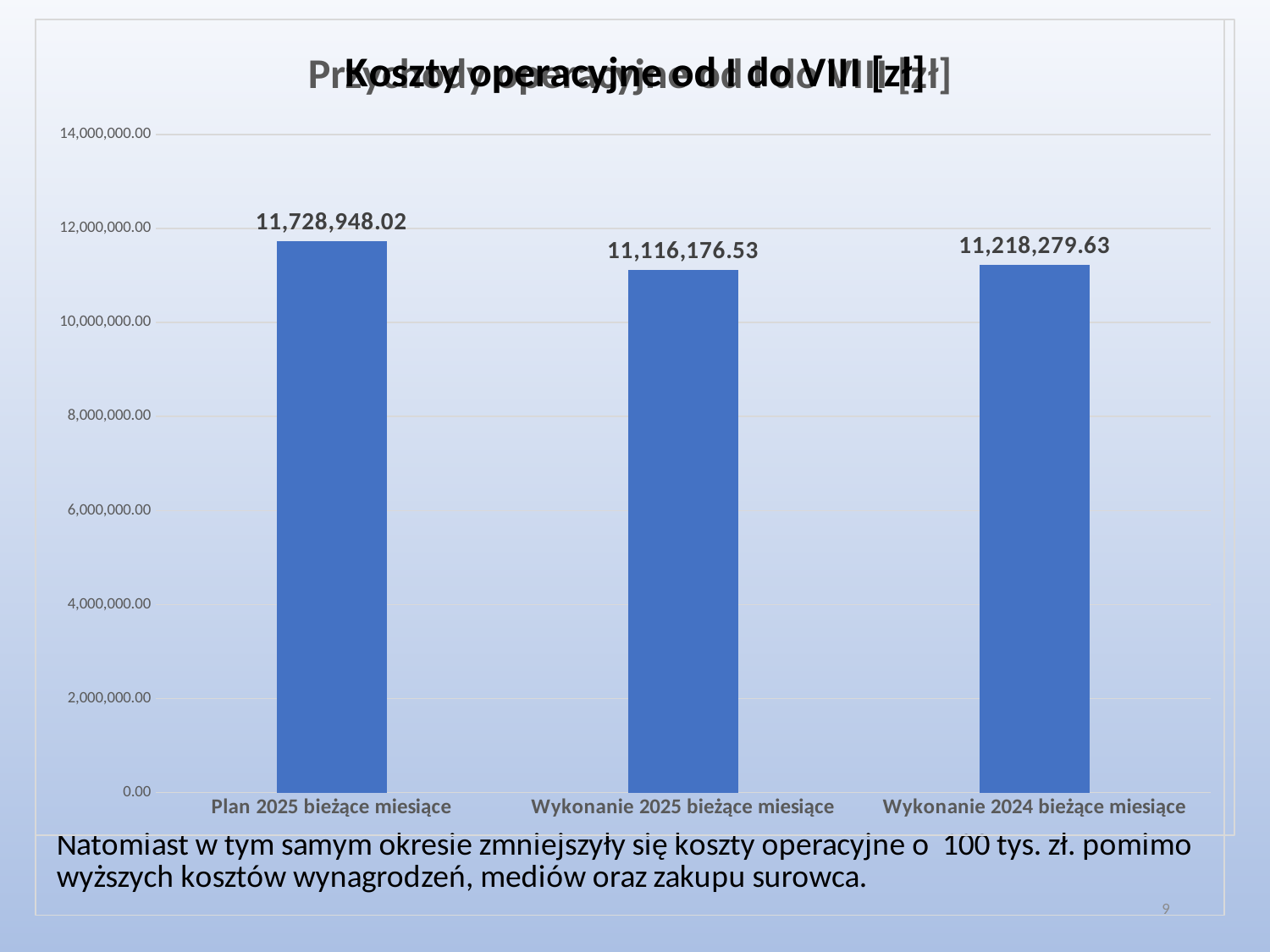
Which category has the highest value? Plan 2025 bieżące miesiące What is the value for Wykonanie 2025 bieżące miesiące? 11,116,176.53 Which category has the lowest value? Wykonanie 2025 bieżące miesiące What kind of chart is shown on the slide? bar chart Which is larger, Plan 2025 bieżące miesiące or Wykonanie 2024 bieżące miesiące? Plan 2025 bieżące miesiące What is the value for Wykonanie 2024 bieżące miesiące? 11,218,279.63 What is the value for Plan 2025 bieżące miesiące? 11,728,948.02 Is the value for Wykonanie 2025 bieżące miesiące greater or less than 12,000,000.00? less Is the value for Plan 2025 bieżące miesiące greater or less than 10,000,000.00? greater What is the difference between Wykonanie 2024 bieżące miesiące and Wykonanie 2025 bieżące miesiące? 102,103.10 What is the difference between Plan 2025 bieżące miesiące and Wykonanie 2025 bieżące miesiące? 612,771.49 How many categories are shown in the chart? 3